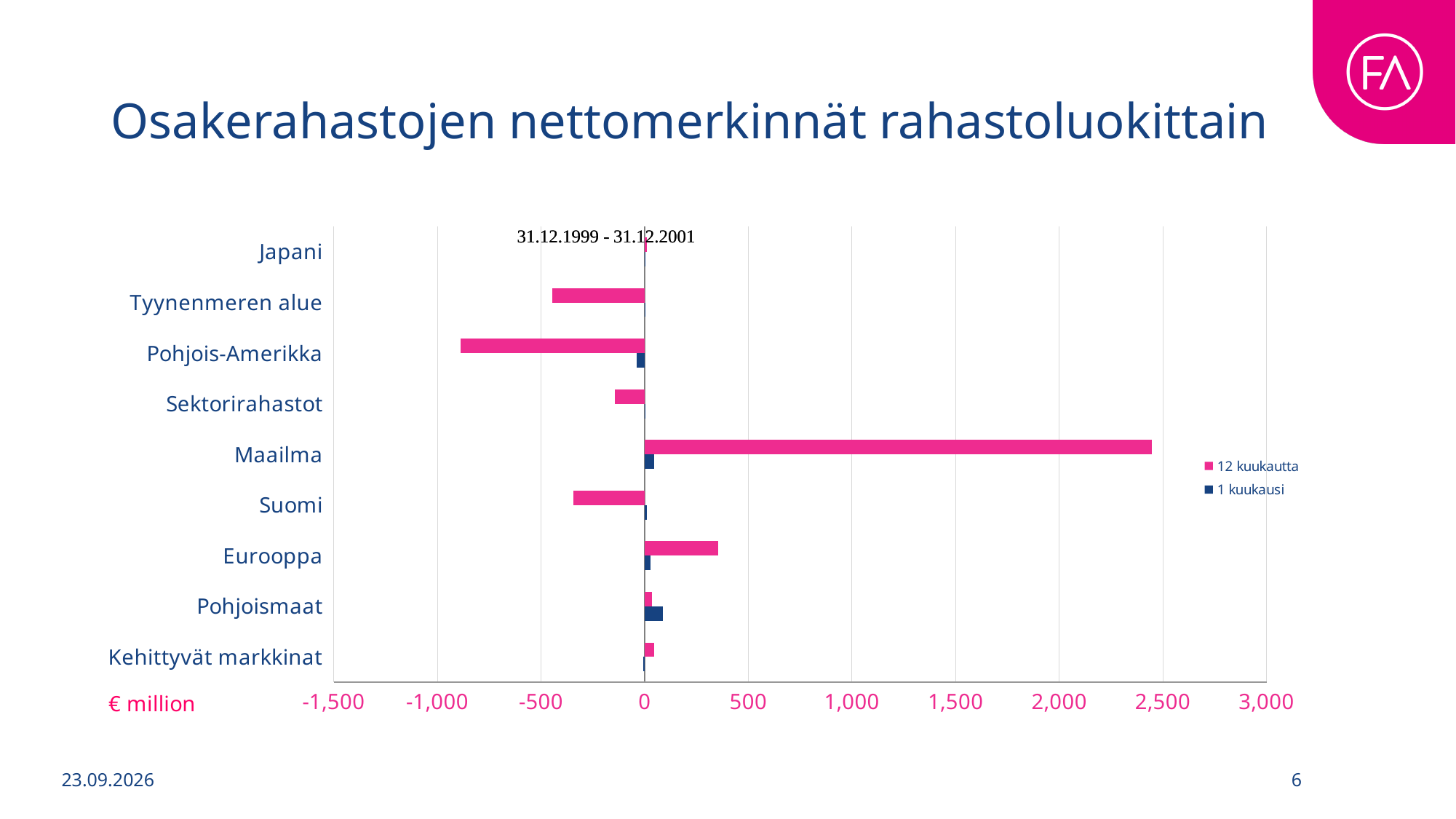
Which is larger, the 12 kuukautta value for Maailma or for Eurooppa? Maailma How many series does the legend list? 2 Is the 12 kuukautta value for Pohjois-Amerikka greater or less than -500? less How many fund categories are shown on the chart? 9 What is the title of the chart on the slide? Osakerahastojen nettomerkinnät rahastoluokittain What kind of chart is shown on the slide? Bar chart Is the 12 kuukautta value for Eurooppa greater or less than 500? less Which category has the highest 1 kuukausi value? Pohjoismaat Is the 12 kuukautta value for Suomi greater or less than 0? less Which category has the highest 12 kuukautta value? Maailma Which category has the lowest 12 kuukautta value? Pohjois-Amerikka